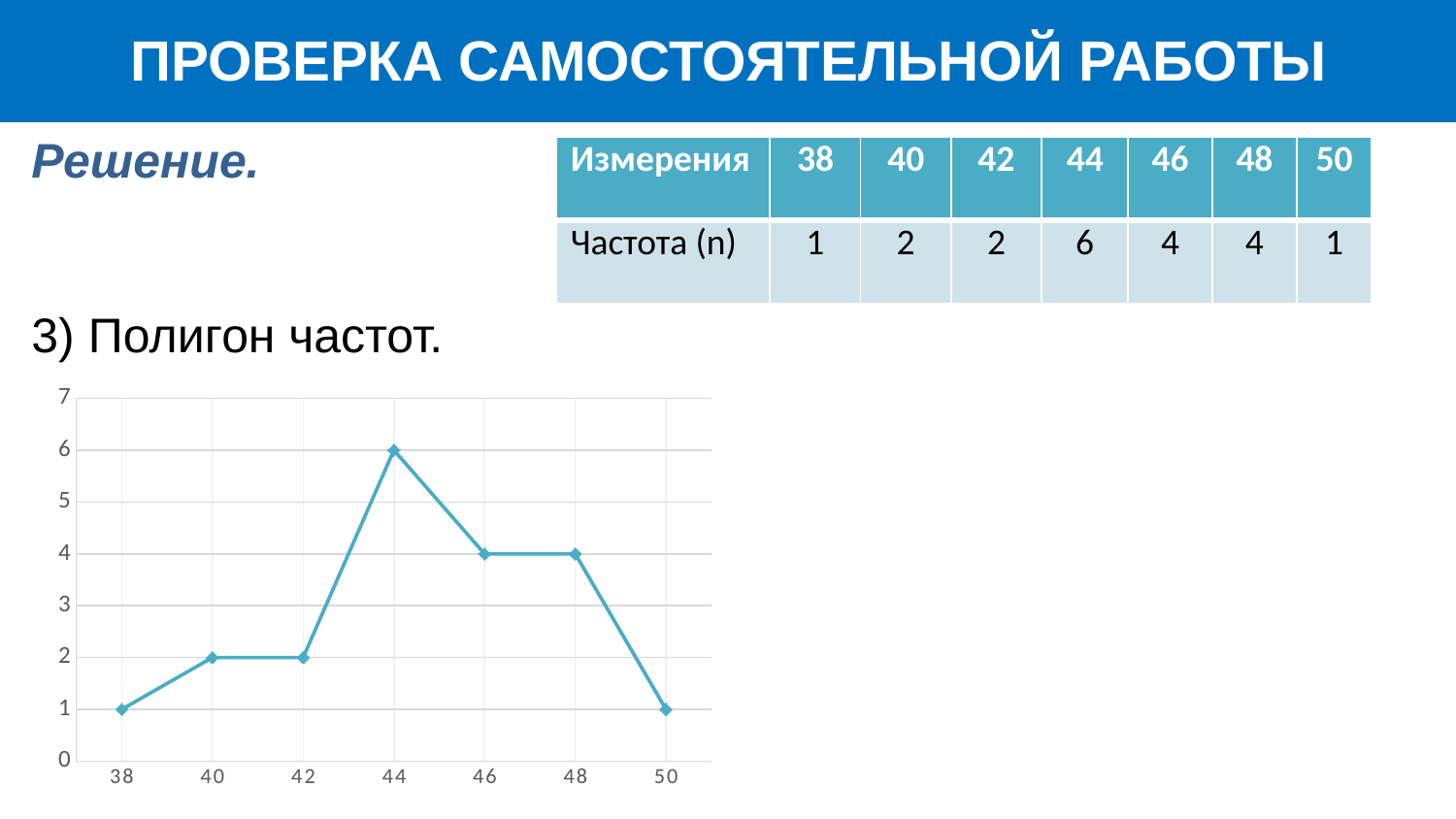
What type of chart is shown on the slide? line chart What is the frequency value plotted for measurement 46? 4 What is the frequency value plotted for measurement 38? 1 What is the highest value shown on the vertical axis of the chart? 7 What is the frequency value plotted for measurement 44? 6 Which measurement has the highest frequency on the chart? 44 How many data points are plotted on the chart? 7 Does the line rise or fall between measurements 48 and 50? fall What is the difference between the frequency at 44 and the frequency at 46? 2 Is the value for measurement 44 greater or less than 5? greater What is the difference between the frequency at 40 and the frequency at 50? 1 Which has a larger frequency on the chart, measurement 40 or measurement 48? 48